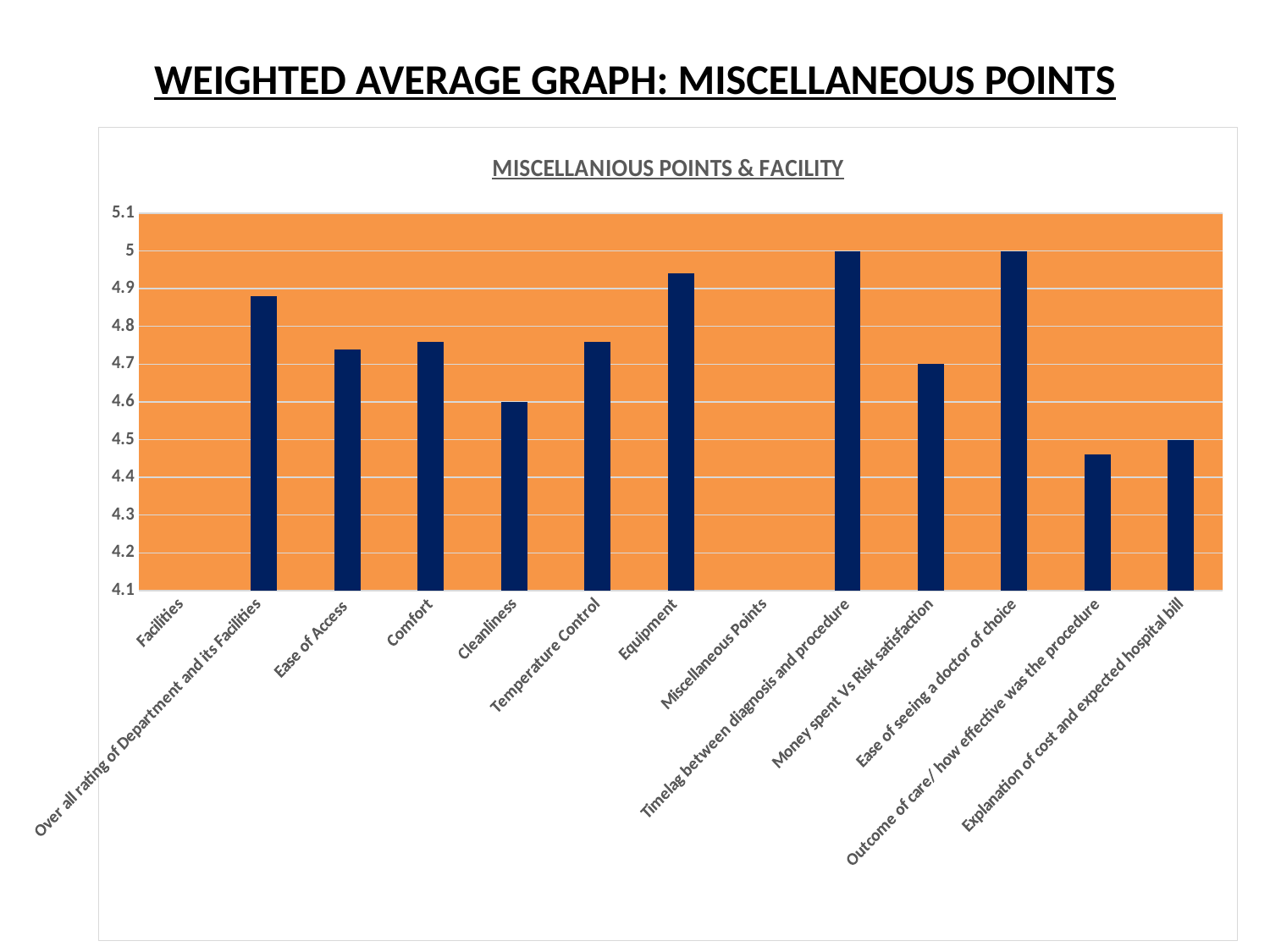
What is the title of the chart? MISCELLANIOUS POINTS & FACILITY What is the value for Money spent Vs Risk satisfaction? 4.7 How many bars are plotted in the chart? 11 What is the value for Cleanliness? 4.6 What is the value for Timelag between diagnosis and procedure? 5 What type of chart is shown on the slide? bar chart Is the value for Ease of Access greater or less than 4.8? less Is the value for Equipment greater or less than 4.8? greater What is the value for Explanation of cost and expected hospital bill? 4.5 Which is larger, the value for Comfort or the value for Cleanliness? Comfort Is the value for Outcome of care/ how effective was the procedure greater or less than 4.6? less What is the value for Ease of seeing a doctor of choice? 5